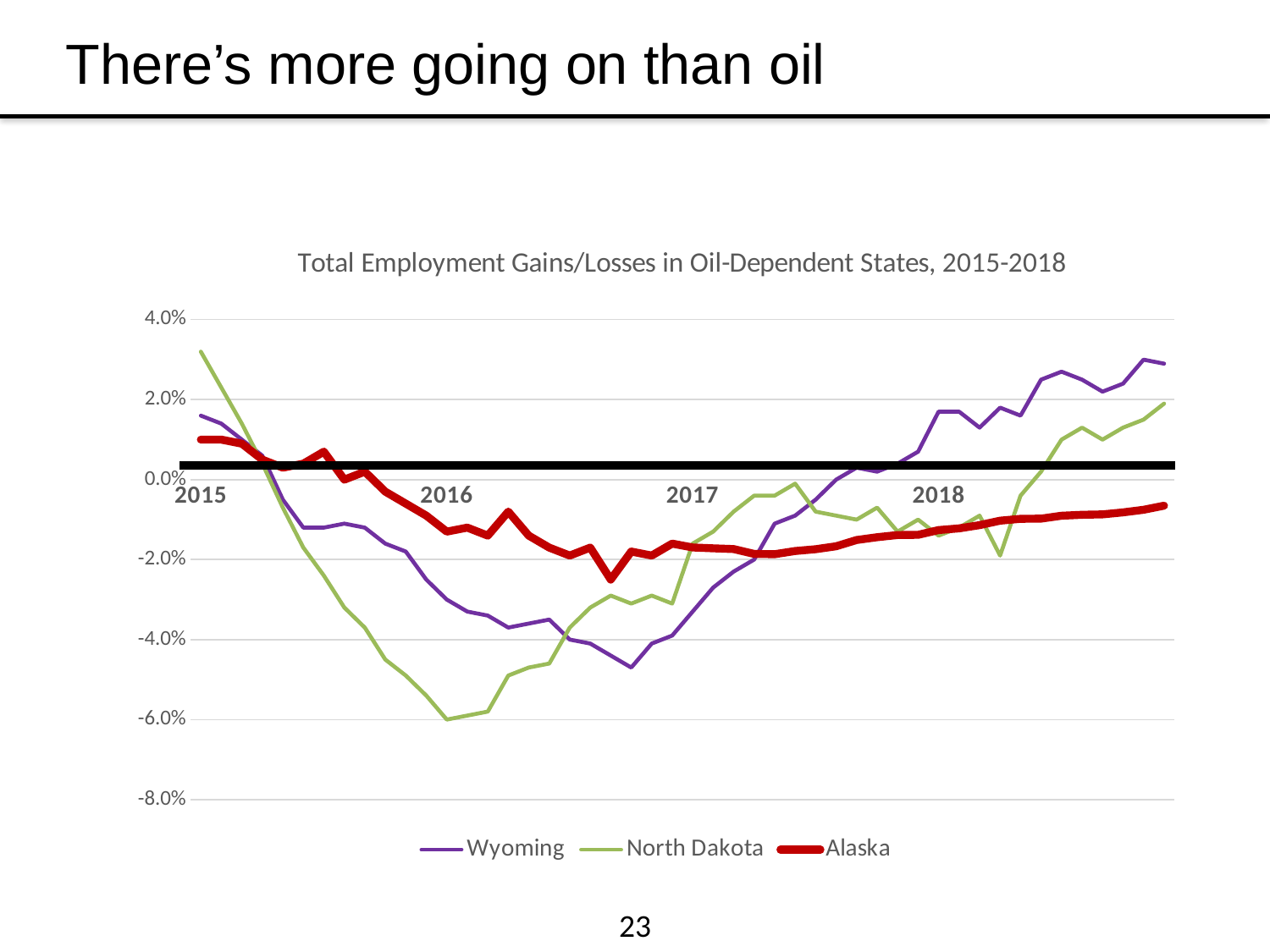
At the start of 2016, which series is lower, Wyoming or North Dakota? North Dakota What kind of chart is shown on the slide? Line chart How many series does the legend list? 3 Which series is drawn with the thick red line? Alaska What is the title of the chart? Total Employment Gains/Losses in Oil-Dependent States, 2015-2018 Does the Wyoming line rise or fall between 2017 and 2018? Rise Is the value for Alaska at the end of 2018 greater or less than 0.0%? less Which series reaches the lowest value on the chart? North Dakota Is the lowest value for North Dakota greater or less than -4.0%? less Which series reaches the highest value on the chart? North Dakota At the end of 2018, which series is higher, Wyoming or Alaska? Wyoming Is the value for Wyoming at the end of 2018 greater or less than 2.0%? greater